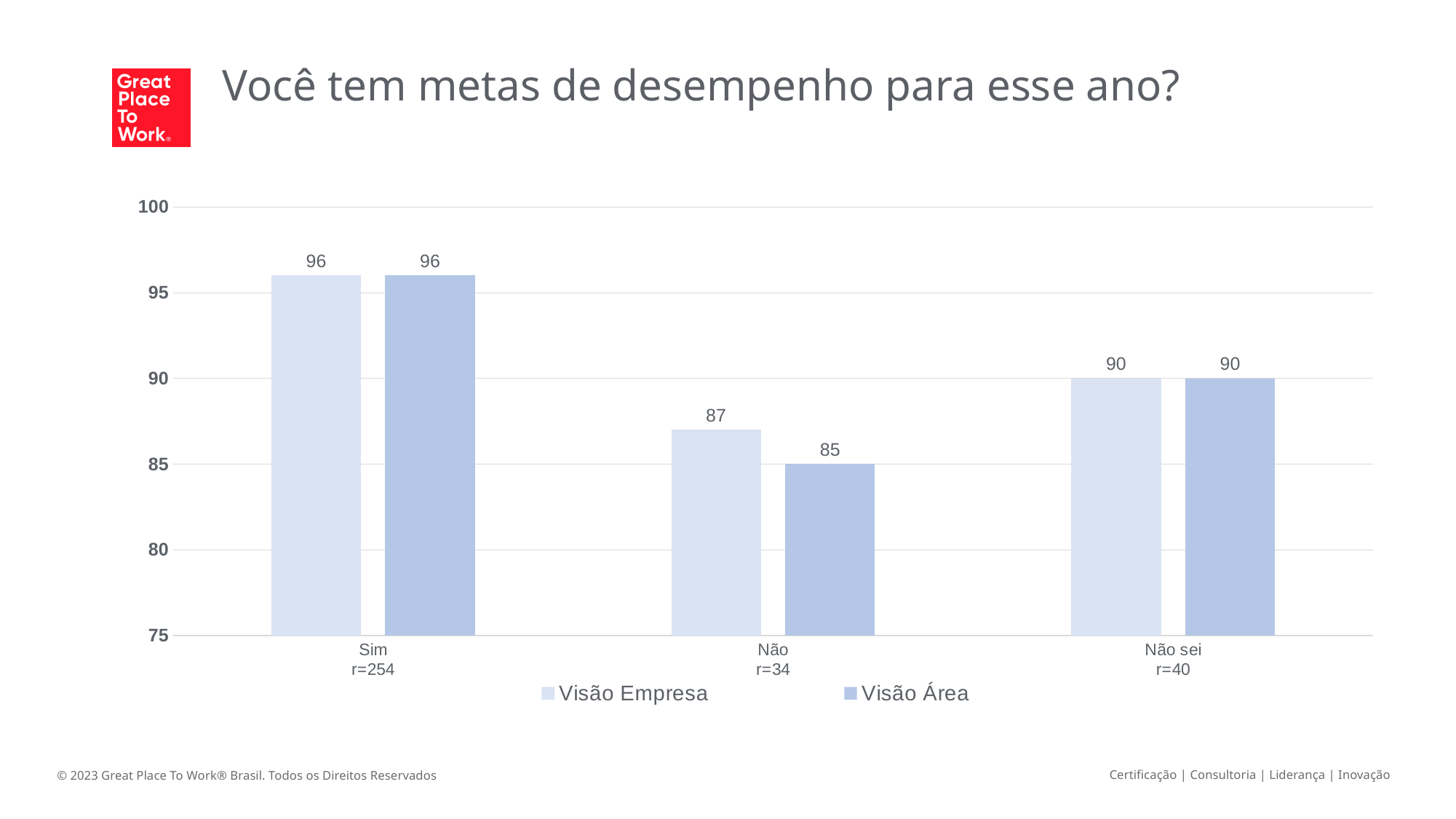
What is the difference between Visão Empresa and Visão Área in the Não category? 2 Which category has the highest value for Visão Empresa? Sim How many categories are shown on the x axis? 3 What kind of chart is shown on the slide? bar chart Which is larger in the Não category, Visão Empresa or Visão Área? Visão Empresa Which category has the lowest value for Visão Área? Não What is the value for Visão Área in the Não category? 85 What is the value for Visão Empresa in the Não sei category? 90 What is the difference between the Visão Empresa values for Sim and Não? 9 How many series does the legend list? 2 What is the number of respondents (r) shown for the Sim category? r=254 What is the value for Visão Empresa in the Sim category? 96